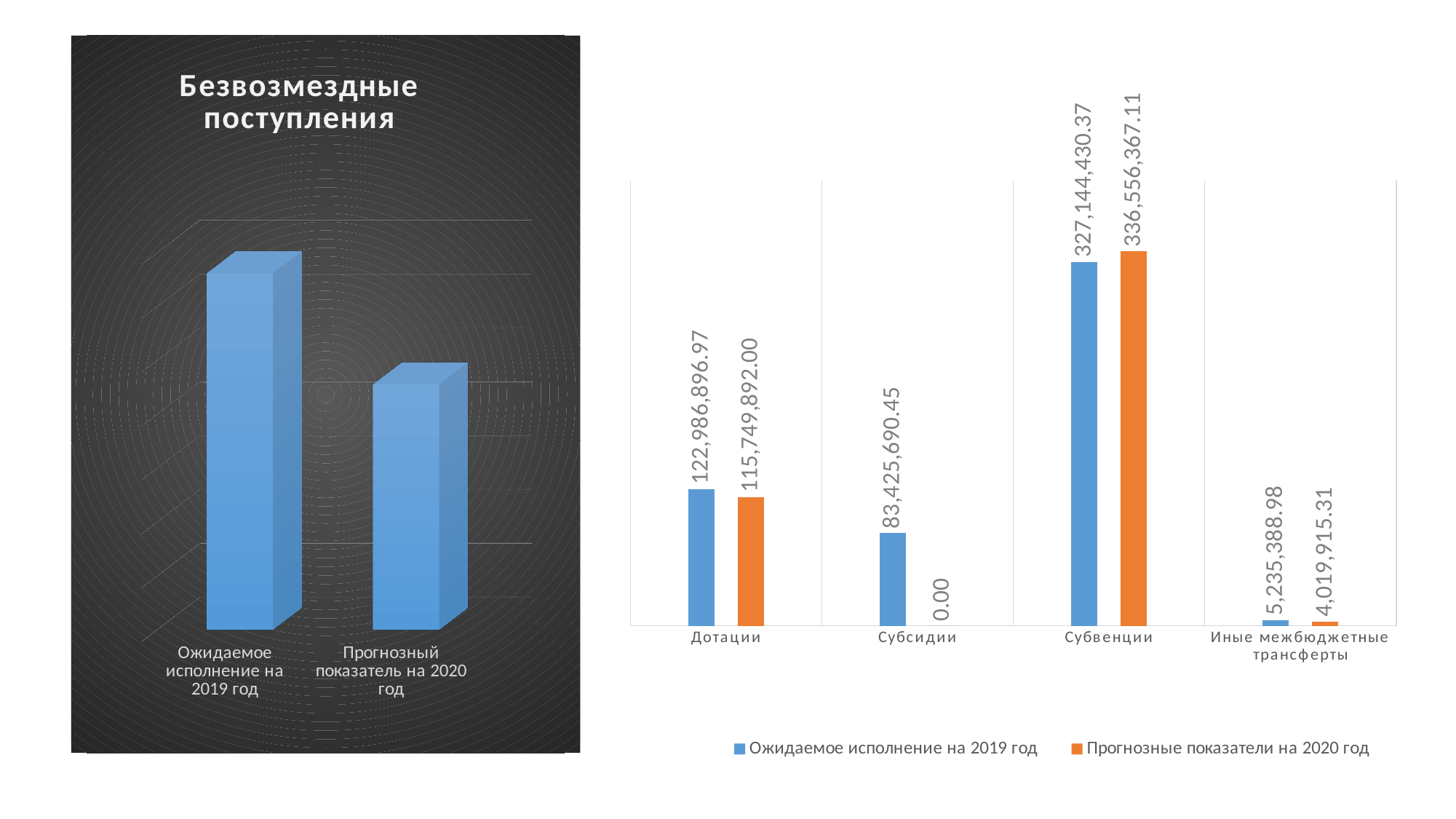
How many categories are shown on the right chart? 4 On the right chart, what is the value of Ожидаемое исполнение на 2019 год for Иные межбюджетные трансферты? 5,235,388.98 On the right chart, what is the value of Прогнозные показатели на 2020 год for Субсидии? 0.00 On the left chart titled Безвозмездные поступления, which bar is taller: Ожидаемое исполнение на 2019 год or Прогнозный показатель на 2020 год? Ожидаемое исполнение на 2019 год On the right chart, what is the value of Прогнозные показатели на 2020 год for Субвенции? 336,556,367.11 On the right chart, what is the value of Ожидаемое исполнение на 2019 год for Дотации? 122,986,896.97 On the right chart, which category has the lowest value for Прогнозные показатели на 2020 год? Субсидии How many series does the legend of the right chart list? 2 On the right chart, for Иные межбюджетные трансферты, which is larger: the 2019 value or the 2020 value? 2019 value On the right chart, which category has the highest value for Ожидаемое исполнение на 2019 год? Субвенции On the right chart, what is the difference between the 2020 and 2019 values for Субвенции? 9,411,936.74 On the right chart, what is the difference between the 2019 and 2020 values for Дотации? 7,237,004.97